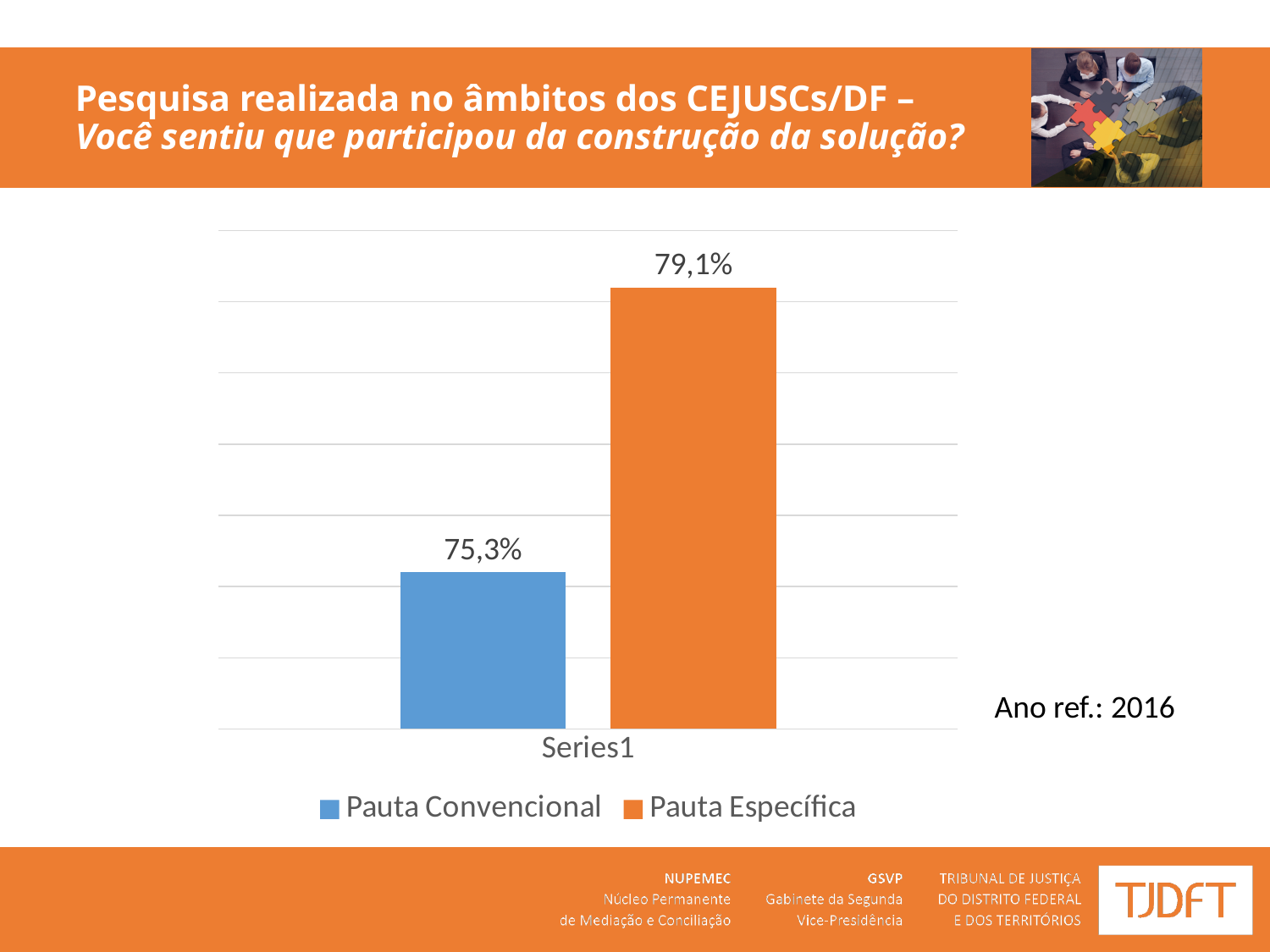
What colour is the bar for Pauta Convencional? Blue Which series has the highest value? Pauta Específica Which series has the lowest value? Pauta Convencional How many series does the legend list? 2 What is the value for Pauta Específica? 79,1% Which series has the higher value, Pauta Convencional or Pauta Específica? Pauta Específica What label appears on the category axis below the bars? Series1 What kind of chart is shown on the slide? Bar chart What is the value for Pauta Convencional? 75,3% How many bars are plotted in the chart? 2 What is the difference between the values for Pauta Específica and Pauta Convencional? 3,8%